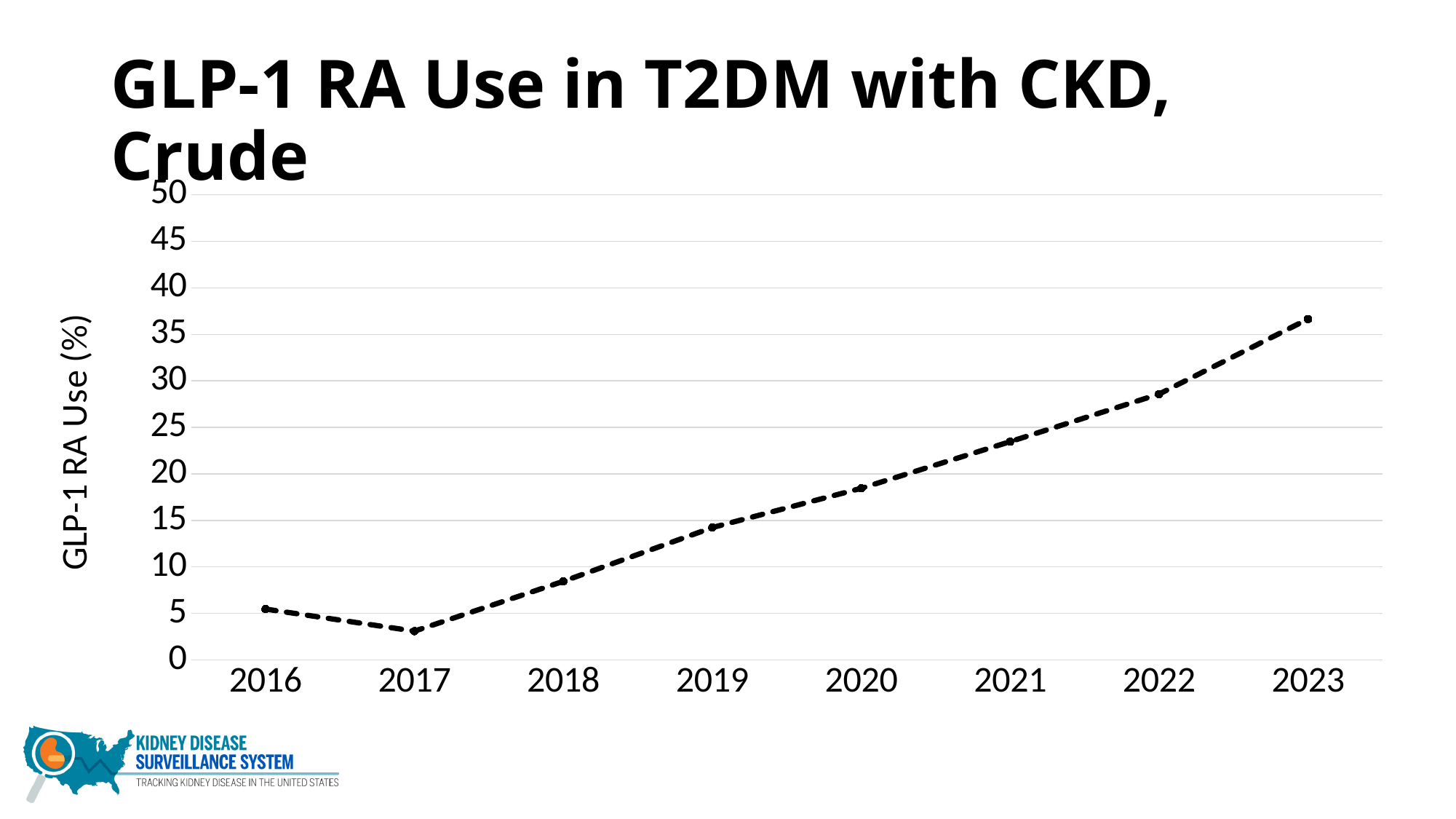
Is the value for 2023 greater or less than 35? greater Which year has the lowest GLP-1 RA use? 2017 Is the value for 2022 greater or less than 30? less What is the label of the y axis? GLP-1 RA Use (%) Is the value for 2017 greater or less than 5? less How many years are plotted on the x axis? 8 Which year has the highest GLP-1 RA use? 2023 Which year has a larger value, 2016 or 2021? 2021 What is the title of the chart? GLP-1 RA Use in T2DM with CKD, Crude Do the values generally rise or fall from 2017 to 2023? rise What kind of chart is shown on the slide? line chart